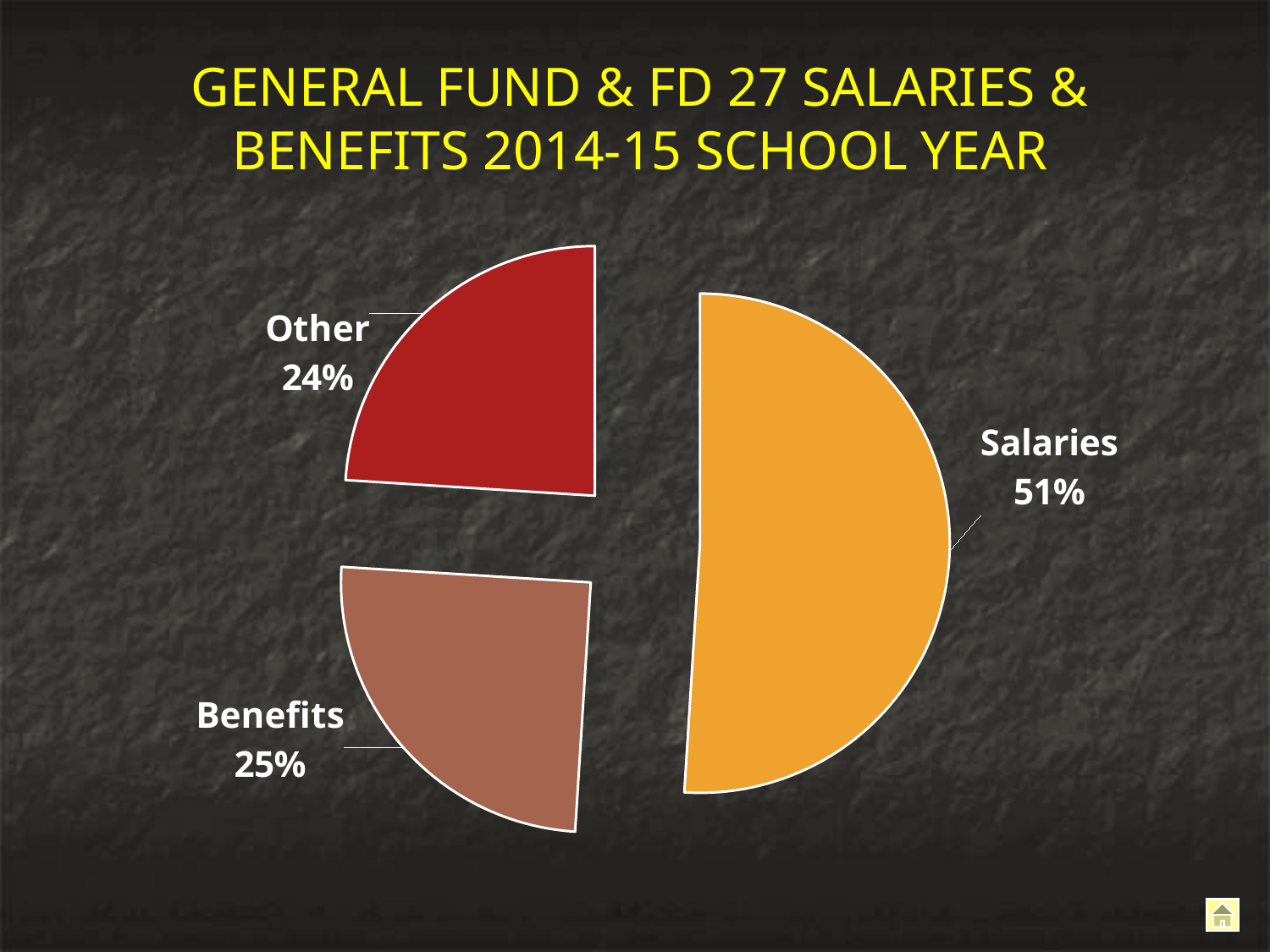
What is the combined share of Benefits and Other? 49% What type of chart is shown on the slide? pie chart What is the difference in percentage points between Salaries and Benefits? 26 How many slices does the pie chart have? 3 Which is larger, the Salaries slice or the Benefits slice? Salaries What share of the pie does Benefits represent? 25% What is the title of the chart on the slide? GENERAL FUND & FD 27 SALARIES & BENEFITS 2014-15 SCHOOL YEAR What share of the pie does Salaries represent? 51% What share of the pie does Other represent? 24% Which category has the largest slice of the pie? Salaries What colour is the Salaries slice? orange What is the difference in percentage points between Salaries and Other? 27